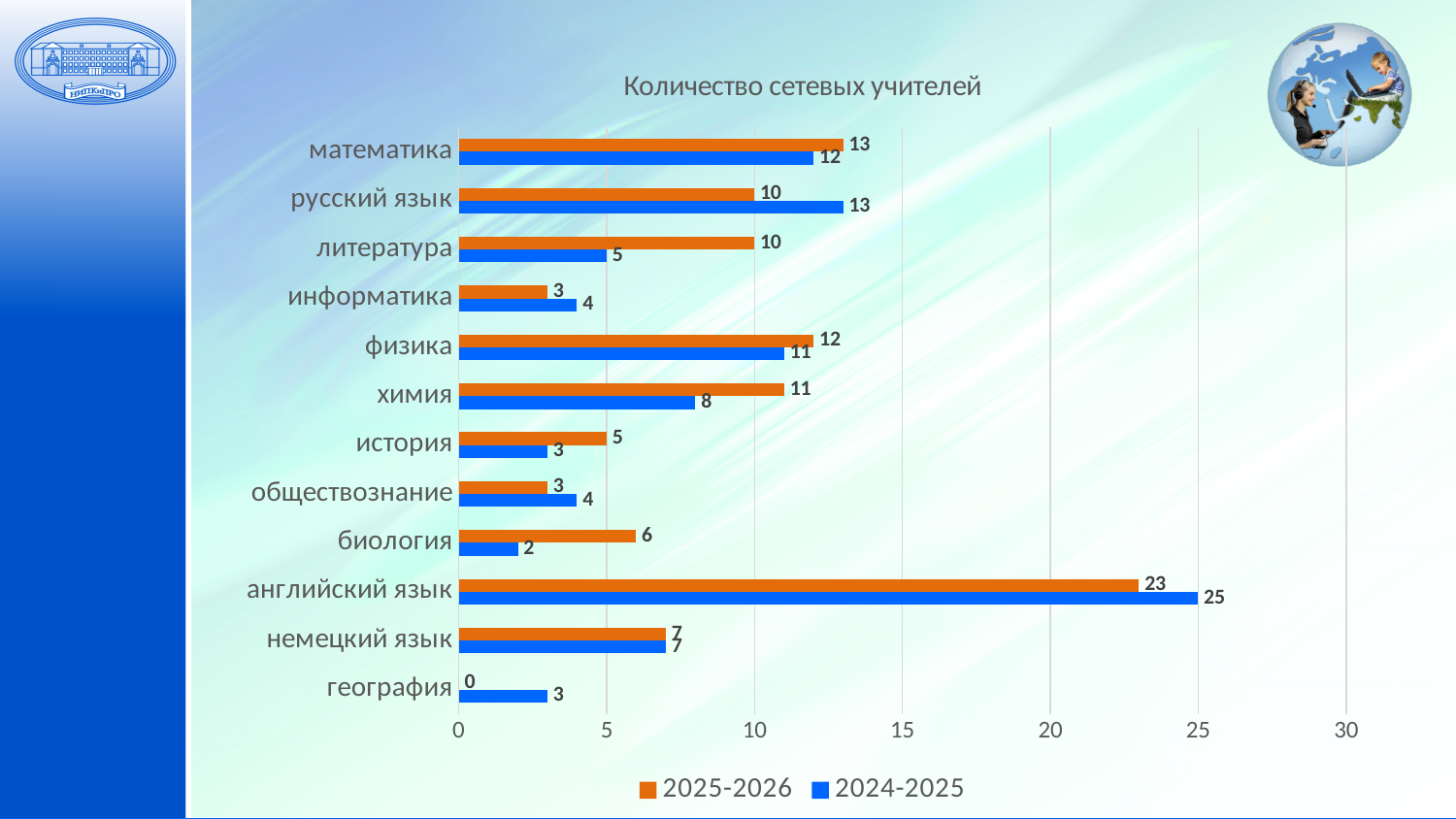
What kind of chart is shown on the slide? bar chart What is the title of the chart? Количество сетевых учителей Which category has the highest value in the 2025-2026 series? английский язык How many series does the legend list? 2 What is the difference between the 2024-2025 and 2025-2026 values for химия? 3 What is the value for география in the 2025-2026 series? 0 What is the value for английский язык in the 2024-2025 series? 25 What is the value for литература in the 2025-2026 series? 10 Which category has the lowest value in the 2024-2025 series? биология Is the value for английский язык in the 2025-2026 series greater or less than 20? greater For русский язык, which series has the larger value, 2025-2026 or 2024-2025? 2024-2025 How many categories are shown on the chart? 12